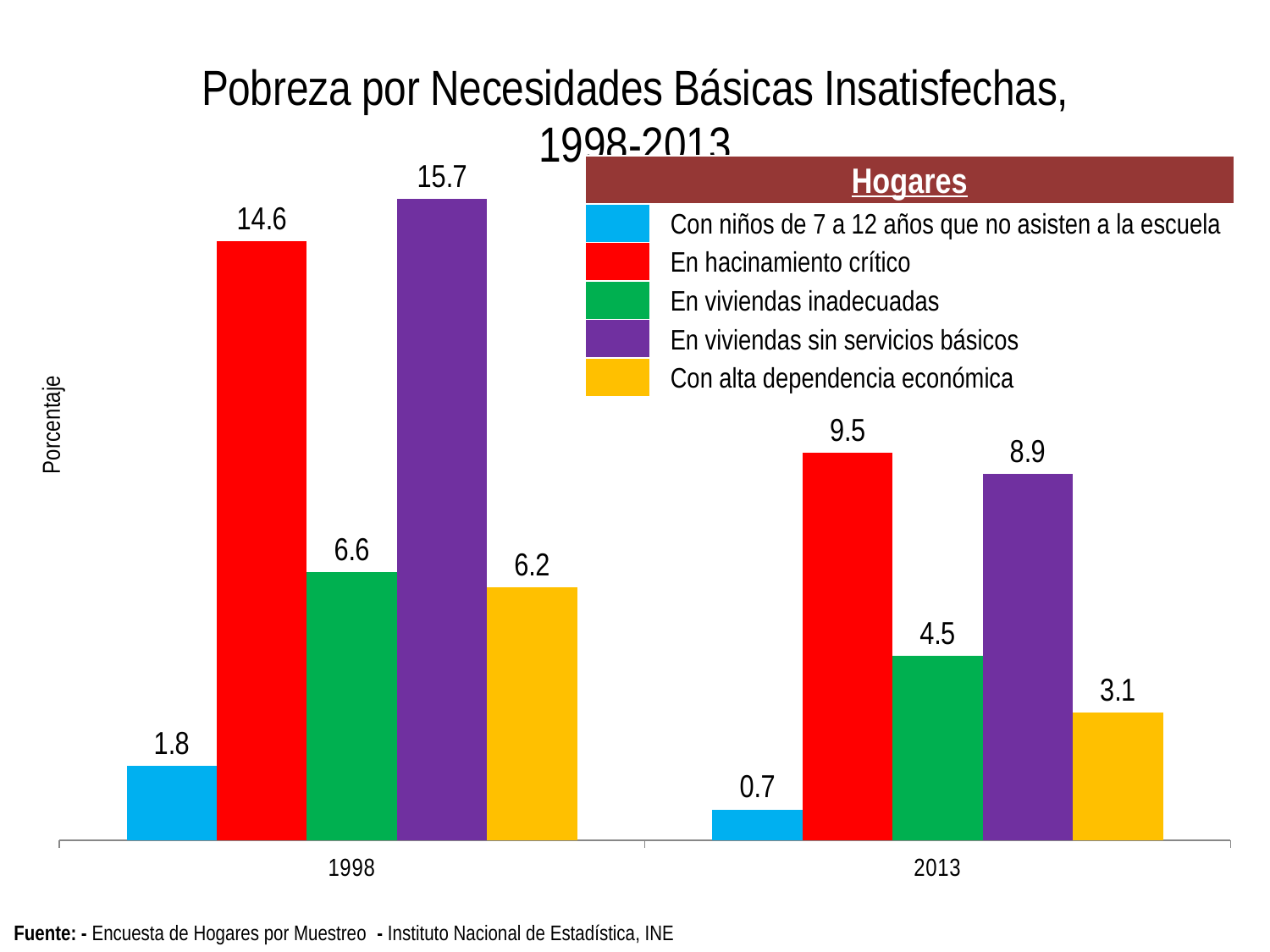
What kind of chart is shown on the slide? Bar chart How many series does the legend list? 5 What is the value for 'En viviendas sin servicios básicos' in 2013? 8.9 Do the values for 'En viviendas inadecuadas' rise or fall from 1998 to 2013? Fall What is the difference between the 1998 and 2013 values for 'En hacinamiento crítico'? 5.1 Which series has the highest value in 1998? En viviendas sin servicios básicos What is the value for 'En hacinamiento crítico' in 1998? 14.6 What is the value for 'Con niños de 7 a 12 años que no asisten a la escuela' in 2013? 0.7 What is the value for 'Con alta dependencia económica' in 1998? 6.2 Which is larger: 'En viviendas inadecuadas' in 1998 or 'Con alta dependencia económica' in 2013? En viviendas inadecuadas in 1998 How many year categories are shown on the x axis? 2 Which series has the lowest value in 2013? Con niños de 7 a 12 años que no asisten a la escuela